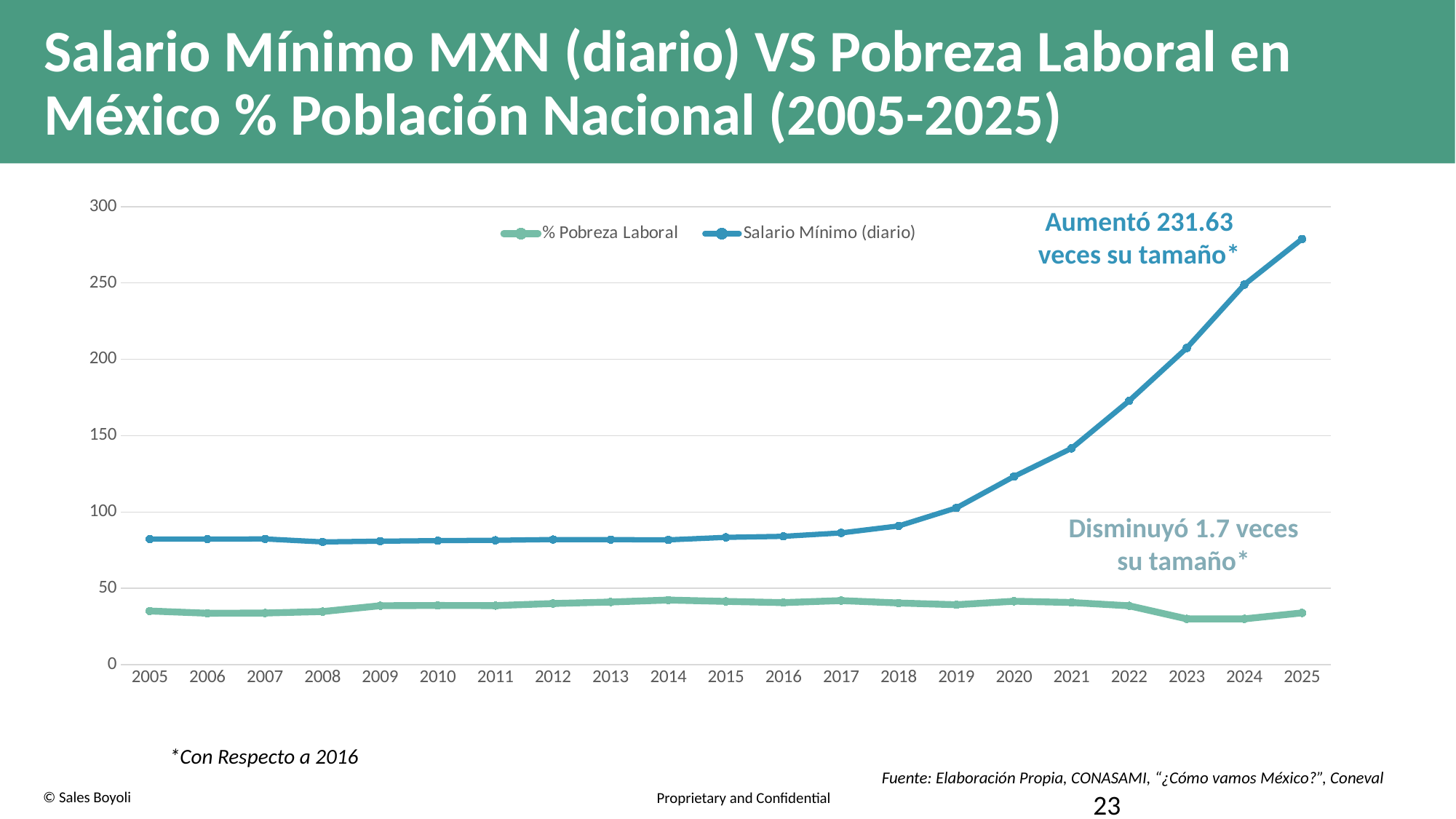
Is the value for Salario Mínimo (diario) in 2025 greater or less than 250? greater Which is larger, the Salario Mínimo (diario) value in 2005 or in 2025? 2025 Which series is drawn in blue? Salario Mínimo (diario) According to the annotation on the chart, by how many times did the Salario Mínimo increase with respect to 2016? 231.63 veces Is the value for Salario Mínimo (diario) in 2021 greater or less than 150? less What kind of chart is shown on the slide? line chart Does the Salario Mínimo (diario) series rise or fall between 2018 and 2025? rise How many years are plotted along the x axis? 21 Is the value for Salario Mínimo (diario) in 2023 greater or less than 200? greater How many series does the legend list? 2 In which year is the Salario Mínimo (diario) series at its highest? 2025